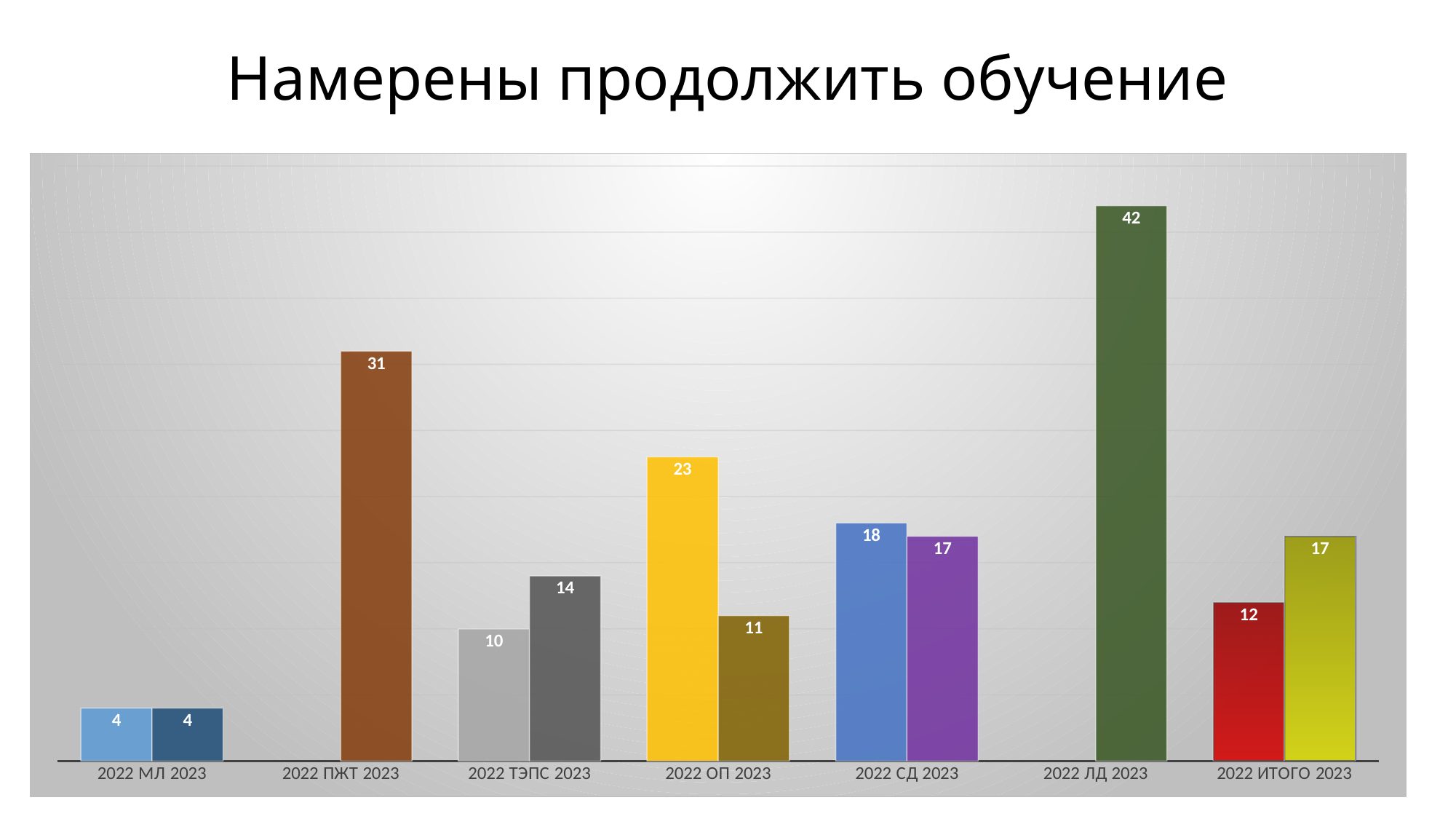
Which is larger for СД: the 2022 value or the 2023 value? 2022 How many groups are shown on the x axis? 7 What is the 2023 value for ТЭПС? 14 What is the difference between the 2023 and 2022 values for ИТОГО? 5 What is the 2023 value for ИТОГО? 17 Which group has the lowest values on the chart? МЛ What type of chart is shown on the slide? Bar chart Which group has the tallest bar on the chart? ЛД (2023) What is the difference between the 2022 and 2023 values for ОП? 12 What is the title of the slide? Намерены продолжить обучение